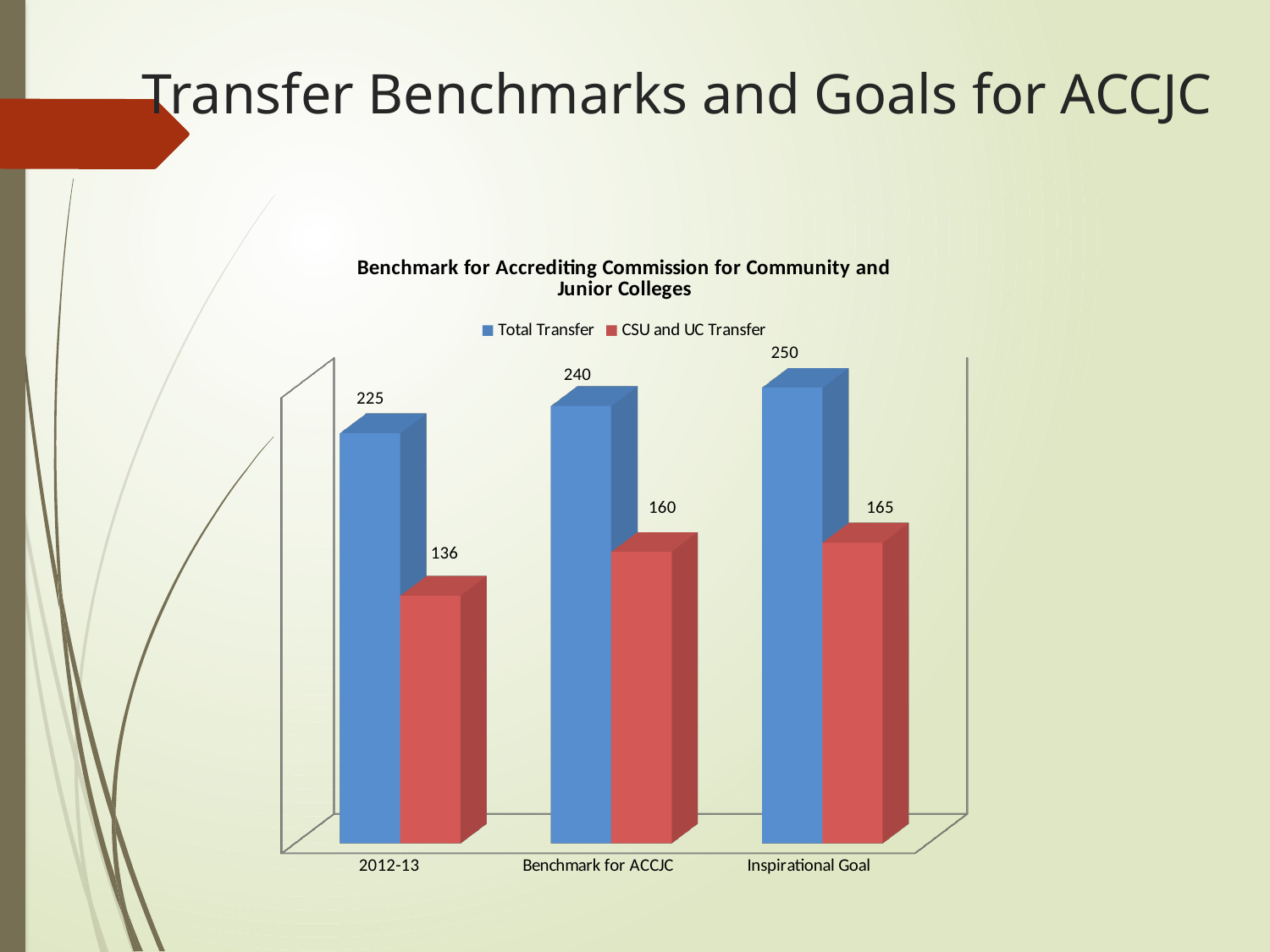
What is the CSU and UC Transfer value for the Inspirational Goal? 165 What kind of chart is shown on the slide? Bar chart What is the Total Transfer value for 2012-13? 225 Which category has the highest Total Transfer value? Inspirational Goal How many categories are shown on the x axis? 3 What is the difference between Total Transfer and CSU and UC Transfer for the Benchmark for ACCJC? 80 How many series does the legend list? 2 Do the Total Transfer values rise or fall from left to right across the categories? Rise What is the CSU and UC Transfer value for the Benchmark for ACCJC? 160 Which is larger: the CSU and UC Transfer value for 2012-13 or for the Benchmark for ACCJC? Benchmark for ACCJC What is the difference between the Total Transfer values for the Inspirational Goal and 2012-13? 25 Which category has the lowest CSU and UC Transfer value? 2012-13